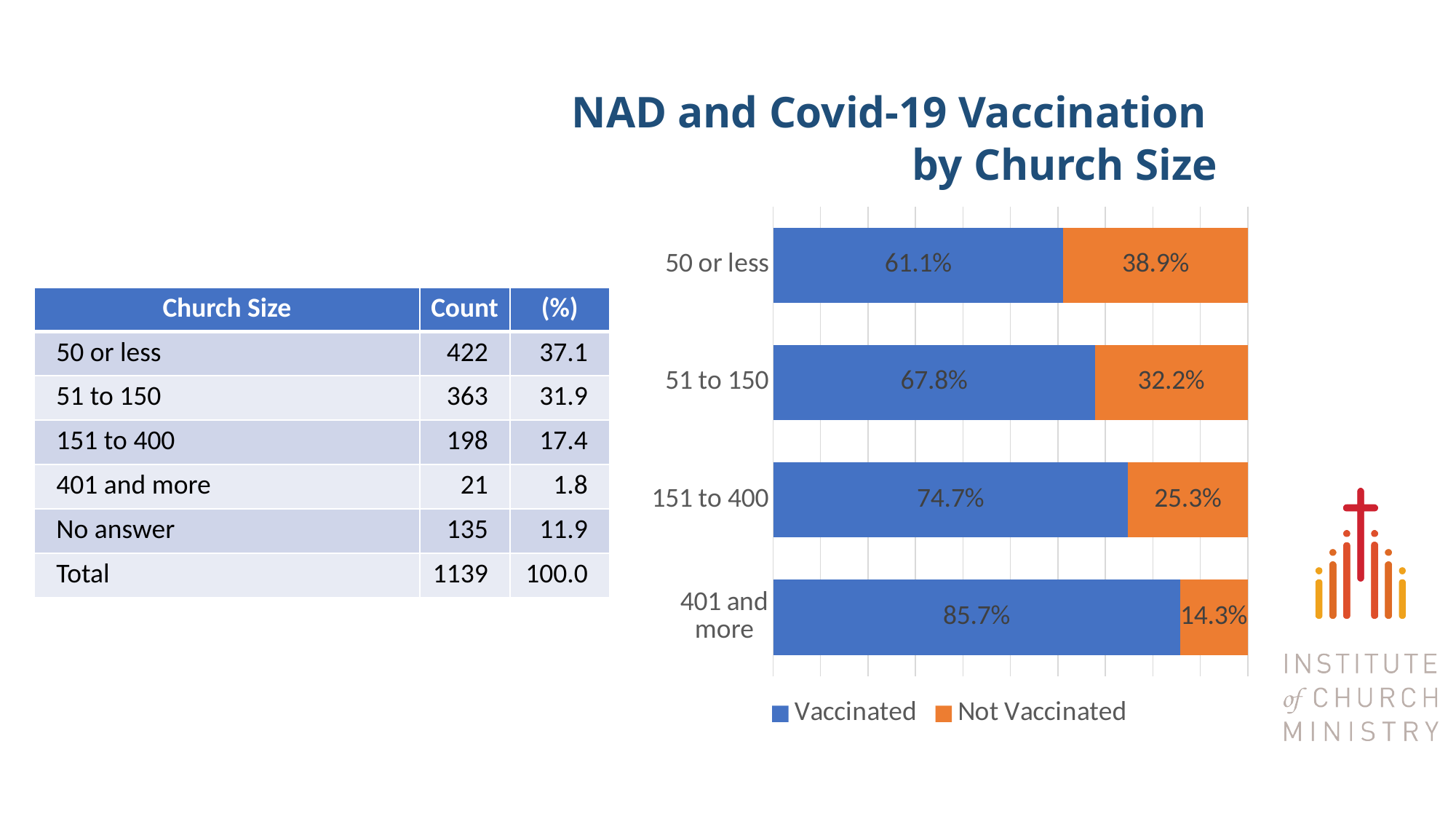
How many church size categories are shown in the chart? 4 What is the title of the chart? NAD and Covid-19 Vaccination by Church Size Does the Vaccinated percentage rise or fall as church size increases from 50 or less to 401 and more? Rise What is the Vaccinated percentage for churches of 401 and more? 85.7% What kind of chart is shown on the slide? Stacked bar chart What is the Vaccinated percentage for churches of 50 or less? 61.1% How many series does the legend list? 2 What is the Not Vaccinated percentage for churches of 151 to 400? 25.3% Which church size category has the lowest Not Vaccinated percentage? 401 and more Which church size category has the highest Vaccinated percentage? 401 and more What is the difference between the Vaccinated percentages for 51 to 150 and 50 or less? 6.7% Which is larger: the Not Vaccinated percentage for 50 or less or for 51 to 150? 50 or less